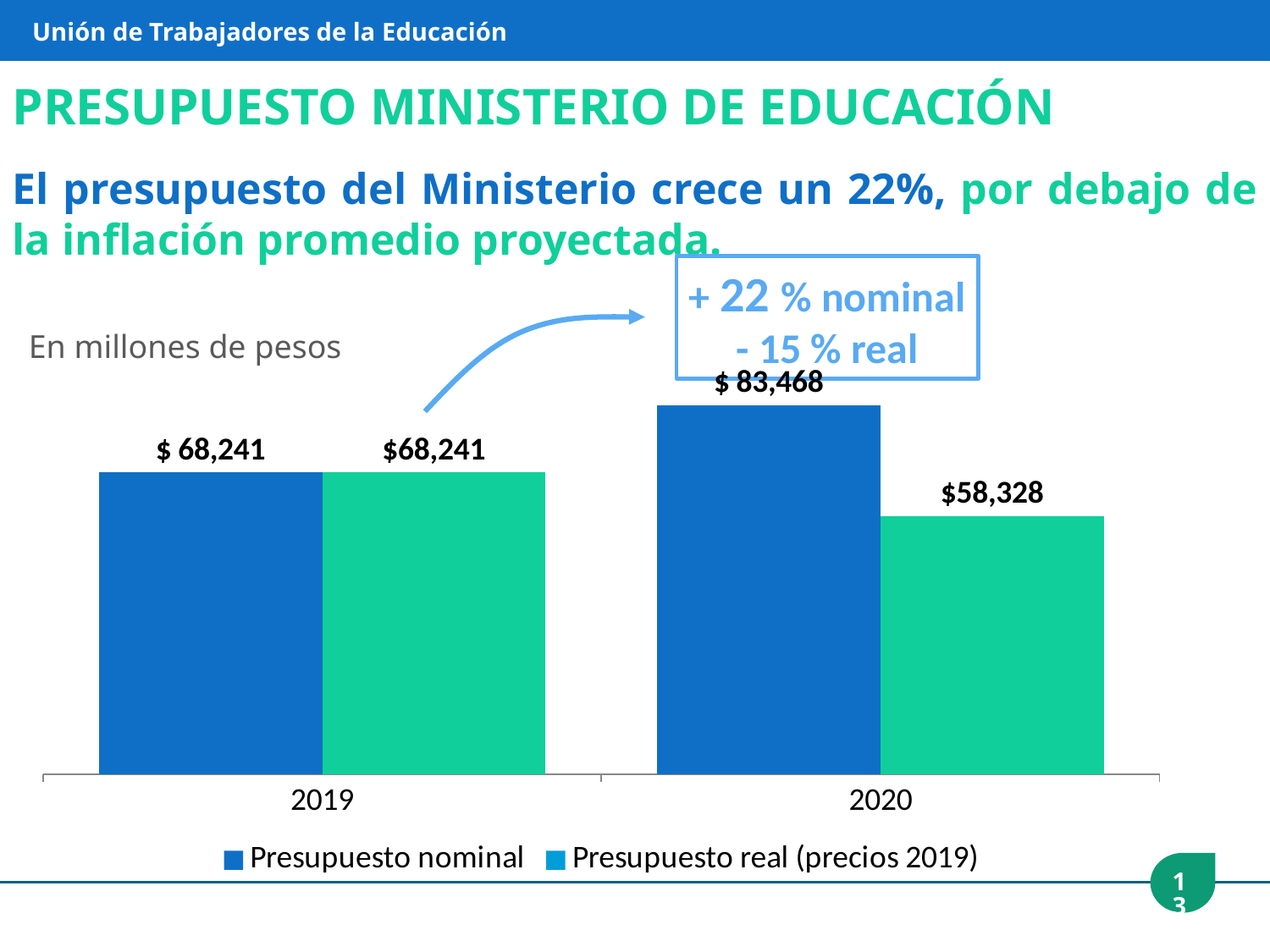
What is the value of Presupuesto real (precios 2019) for 2020? $58,328 By how much does Presupuesto nominal increase from 2019 to 2020? 15,227 What kind of chart is shown on the slide? Bar chart Does Presupuesto real (precios 2019) rise or fall from 2019 to 2020? Fall What is the value of Presupuesto nominal for 2020? $ 83,468 How many series does the legend list? 2 What is the value of Presupuesto nominal for 2019? $ 68,241 Which is larger in 2020: Presupuesto nominal or Presupuesto real (precios 2019)? Presupuesto nominal What is the difference between Presupuesto nominal and Presupuesto real (precios 2019) in 2020? 25,140 Which bar has the lowest value in the chart? Presupuesto real (precios 2019), 2020 Which bar has the highest value in the chart? Presupuesto nominal, 2020 How many years (categories) are shown on the x axis? 2